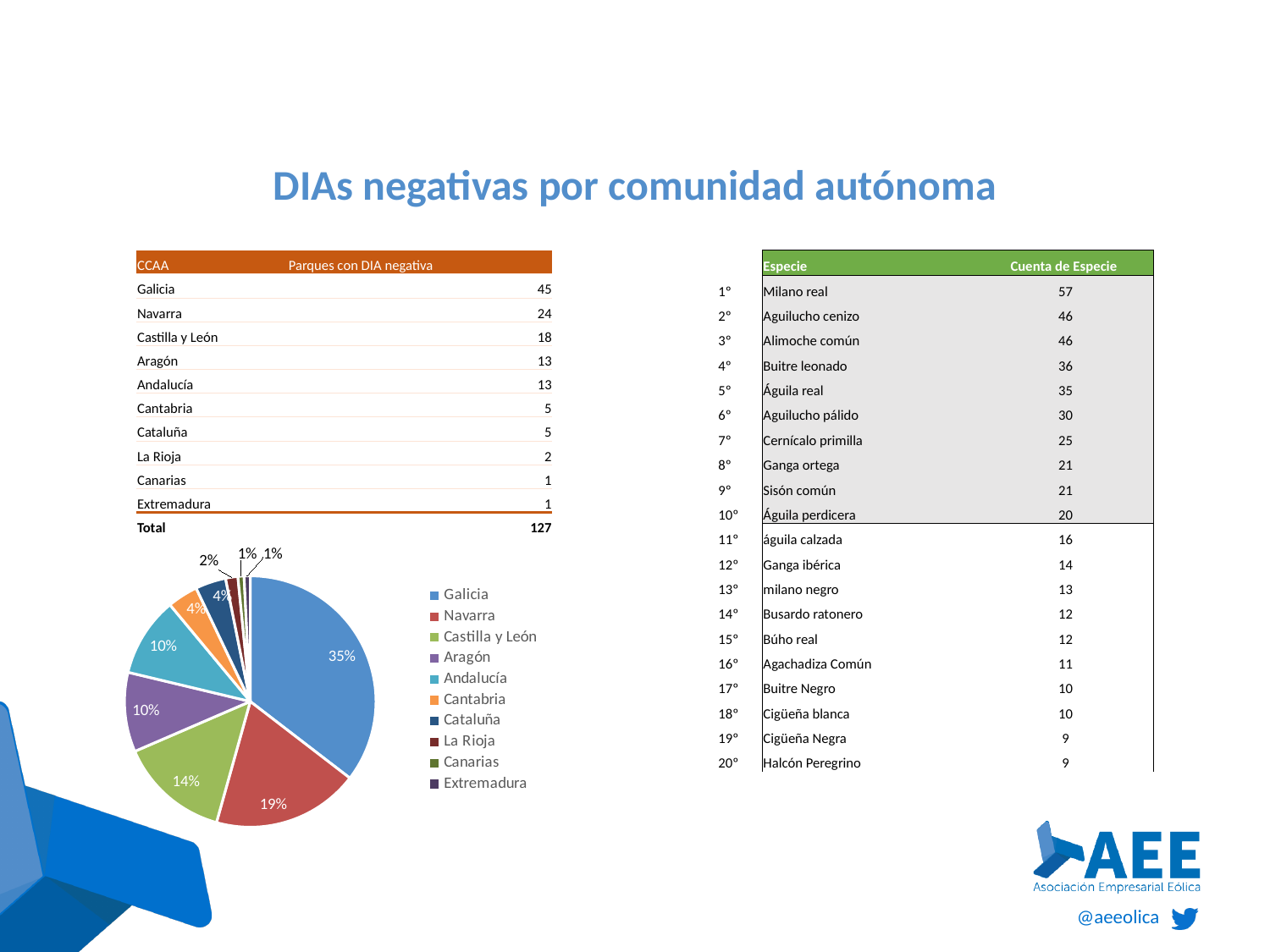
What is the difference in percentage points between the Galicia slice and the Navarra slice? 16% What type of chart is shown on the slide? pie chart What share of the pie chart does Castilla y León represent? 14% What share of the pie chart does Galicia represent? 35% How many categories does the pie chart's legend list? 10 What colour is the Galicia slice in the pie chart? blue What share of the pie chart does Cantabria represent? 4% Which category has the largest slice in the pie chart? Galicia Which slice is larger in the pie chart, Navarra or Castilla y León? Navarra Which category is listed first in the pie chart's legend? Galicia